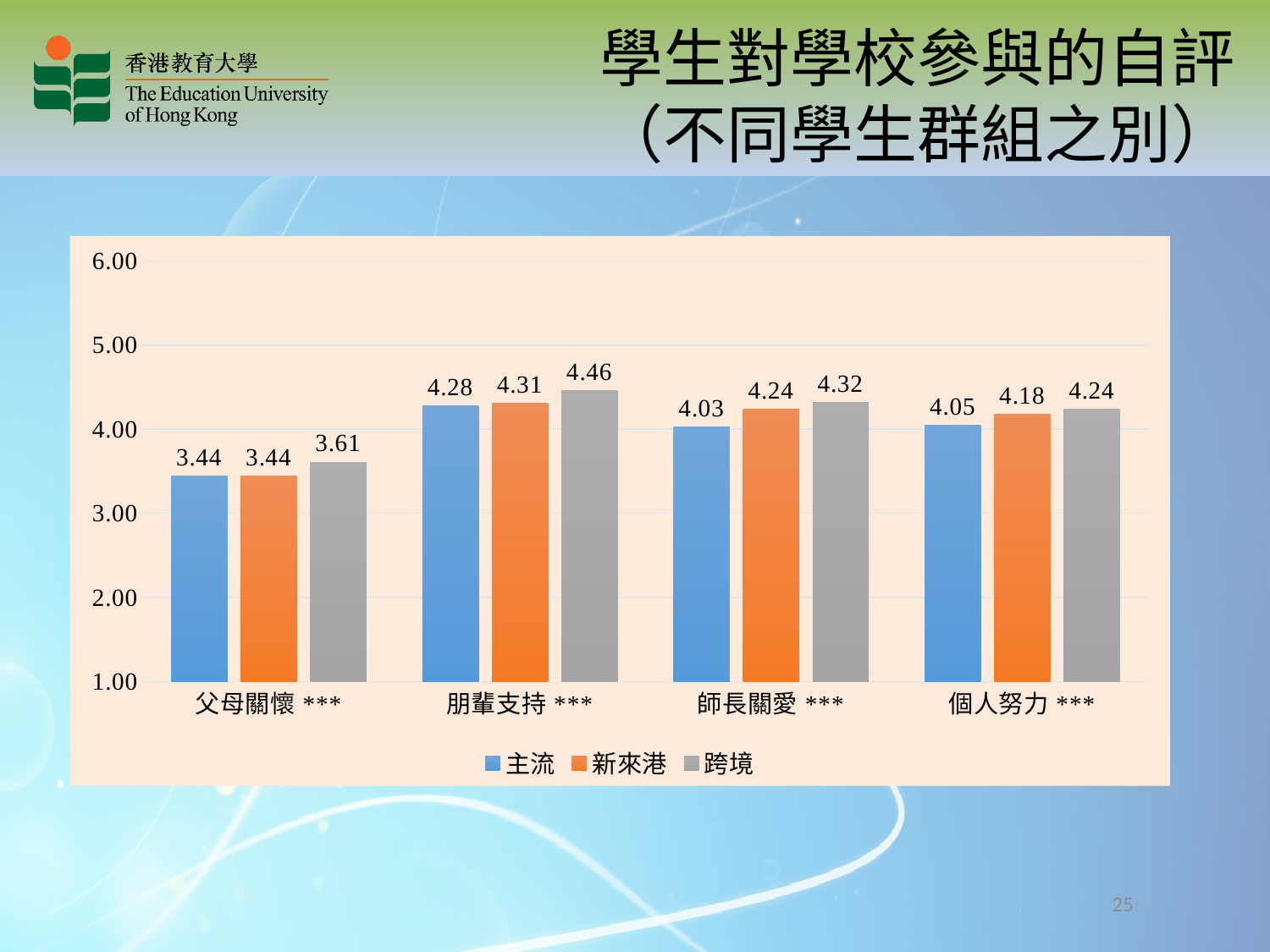
Which category has the highest value for the 跨境 series? 朋輩支持 What is the value for 跨境 in the 朋輩支持 category? 4.46 What is the value for 新來港 in the 師長關愛 category? 4.24 How many categories are shown on the x axis? 4 What kind of chart is shown on the slide? Bar chart Which colour represents the 新來港 series in the legend? Orange What is the value for 主流 in the 父母關懷 category? 3.44 How many series does the legend list? 3 Which category has the lowest value for the 主流 series? 父母關懷 In the 師長關愛 category, which is larger: the 主流 value or the 跨境 value? 跨境 What is the difference between the 跨境 and 主流 values in the 父母關懷 category? 0.17 What is the value for 主流 in the 個人努力 category? 4.05